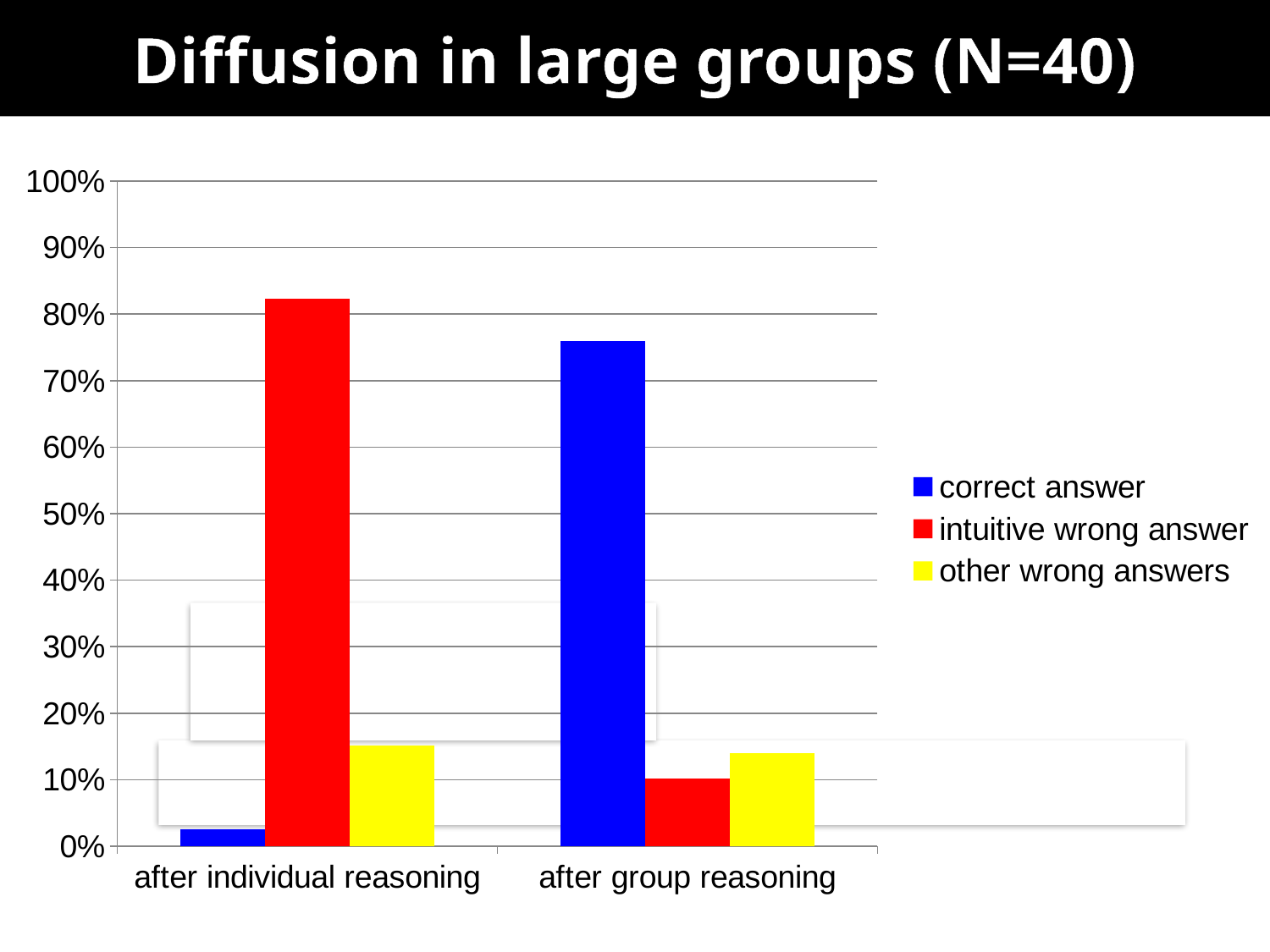
Is the value for 'correct answer' after group reasoning greater or less than 70%? greater How many series does the legend list? 3 Which is larger: 'correct answer' after individual reasoning or 'correct answer' after group reasoning? after group reasoning What colour represents 'other wrong answers' in the chart? yellow Which series has the highest value for 'after group reasoning'? correct answer Is the value for 'correct answer' after individual reasoning greater or less than 10%? less How many categories are shown on the x axis? 2 Which series has the lowest value for 'after individual reasoning'? correct answer Which series has the highest value for 'after individual reasoning'? intuitive wrong answer Which series has the lowest value for 'after group reasoning'? intuitive wrong answer Is the value for 'intuitive wrong answer' after individual reasoning greater or less than 80%? greater What kind of chart is shown on the slide? bar chart